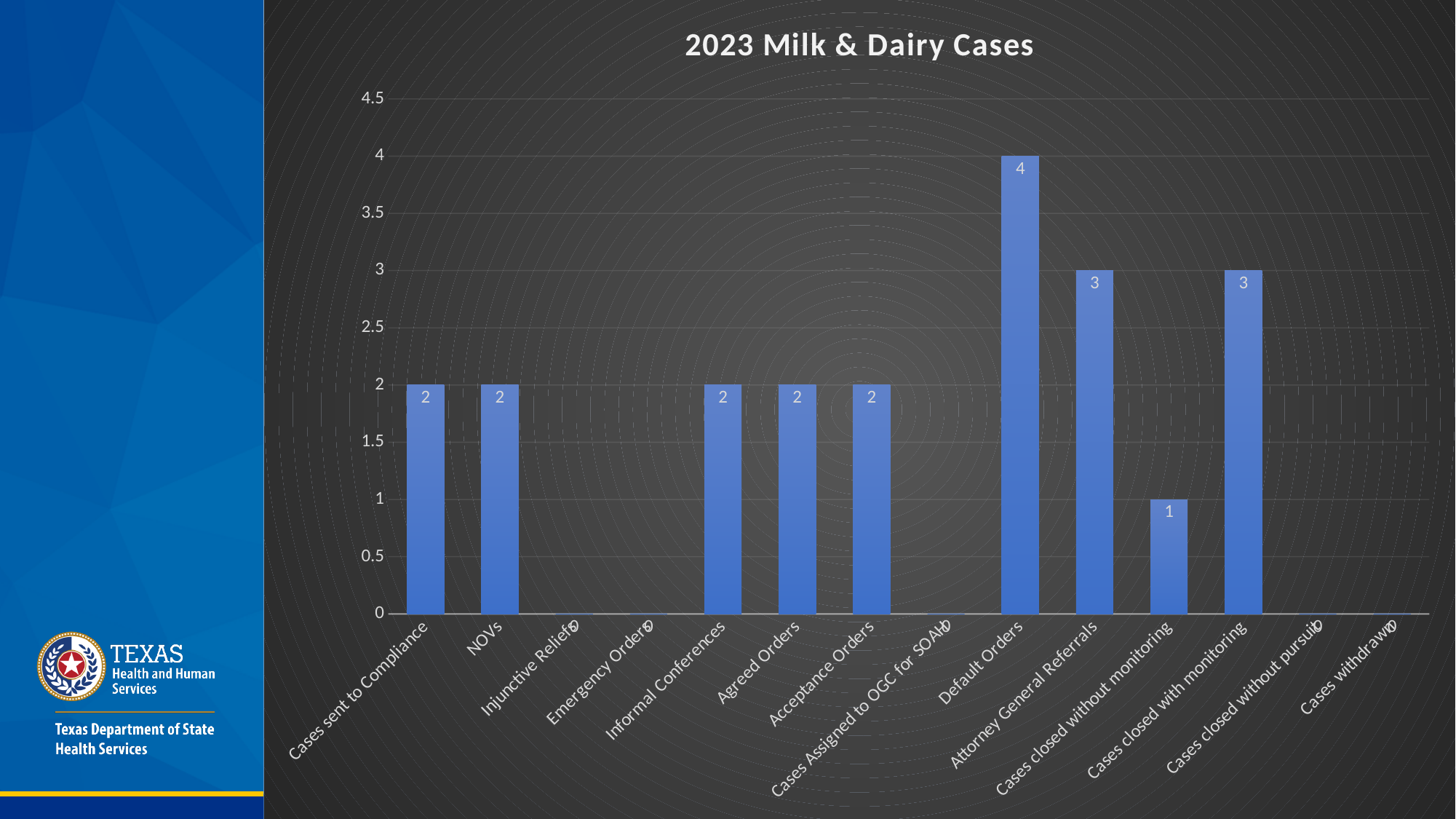
What is the value for Attorney General Referrals? 3 What is the value for Cases closed without monitoring? 1 What kind of chart is this? bar chart What is the value for NOVs? 2 Which category has the highest value? Default Orders What is the value for Cases closed with monitoring? 3 Which is larger, Attorney General Referrals or Informal Conferences? Attorney General Referrals What is the title of the chart? 2023 Milk & Dairy Cases How many categories are shown on the x axis? 14 What is the difference between Default Orders and Cases closed without monitoring? 3 What is the value for Default Orders? 4 Is the value for Default Orders greater or less than 3.5? greater